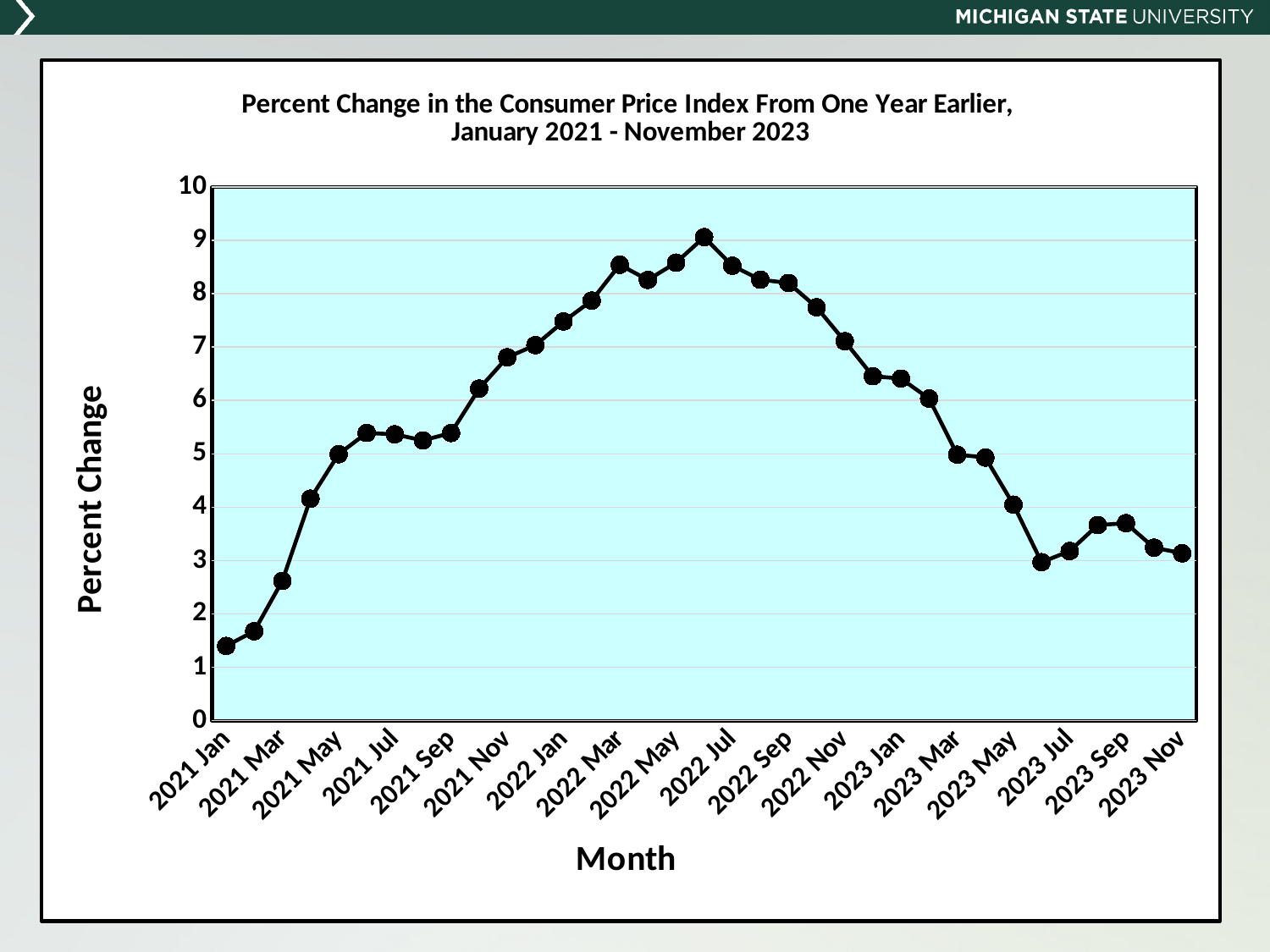
Is the value for 2022 Mar greater or less than 8? greater Is the value for 2023 Jan greater or less than 6? greater Is the value for 2023 Nov greater or less than 4? less In which year does the line reach its highest value? 2022 Does the line rise or fall between 2021 Jan and 2022 Jul? rise Which labeled month has the lowest percent change on the chart? 2021 Jan What kind of chart is shown on the slide? line chart Does the line rise or fall between 2022 Jul and 2023 Jul? fall What is the title of the vertical axis? Percent Change Which has the larger value, 2022 Mar or 2023 Mar? 2022 Mar